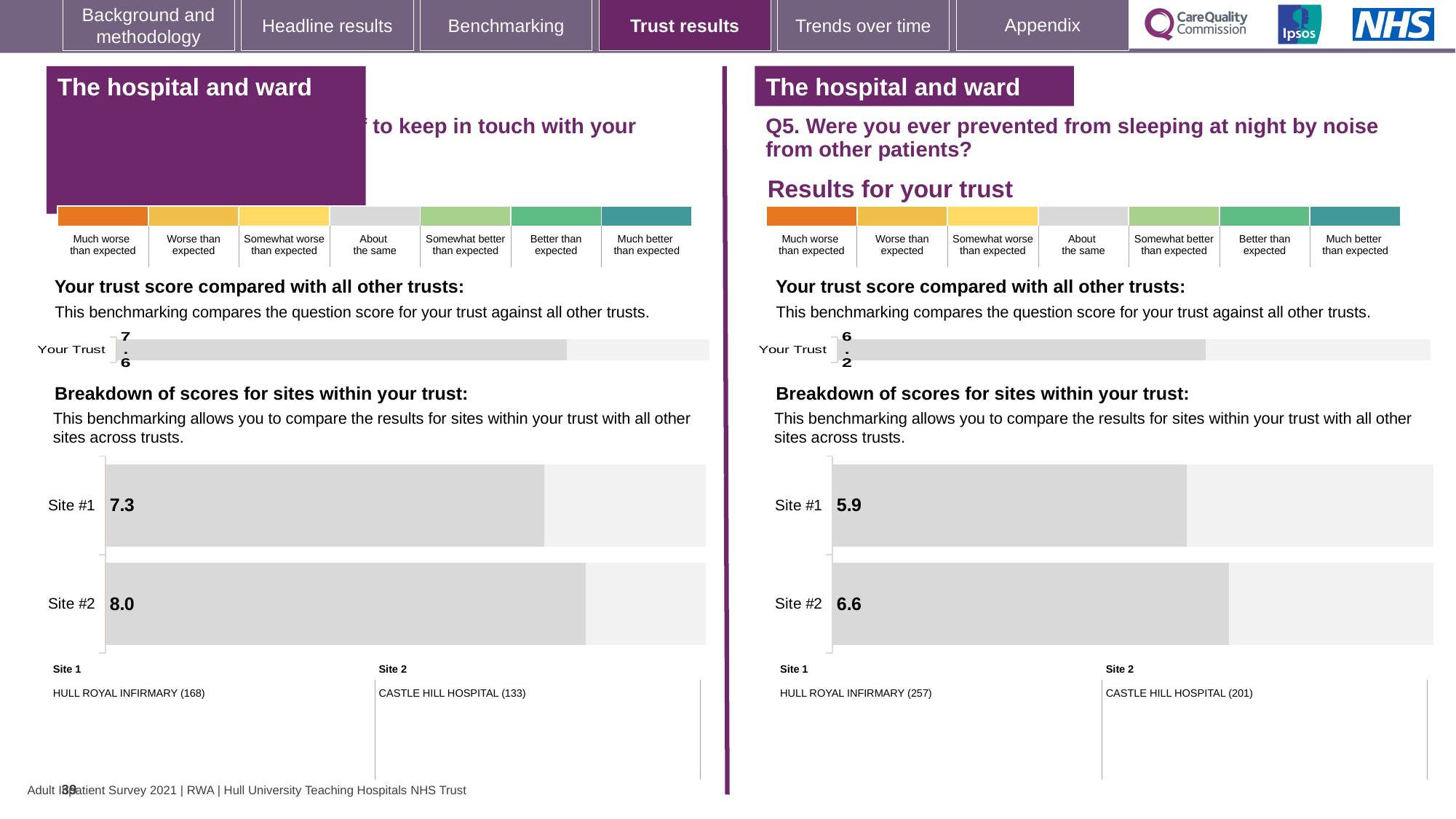
On the left-hand site breakdown chart, what is the difference between the Site #2 score and the Site #1 score? 0.7 On the left-hand site breakdown chart, which site has the lowest score? Site #1 On the right-hand chart for Q5, what is the difference between the Site #2 score and the Site #1 score? 0.7 On the right-hand chart for Q5 (prevented from sleeping at night by noise from other patients), what is the score for Site #2? 6.6 On the right-hand chart for Q5 (prevented from sleeping at night by noise from other patients), what is the score for Site #1? 5.9 On the right-hand chart for Q5, which site has the higher score, Site #1 or Site #2? Site #2 What type of chart is used for the site breakdown on the right-hand side (Q5)? Bar chart On the right-hand side of the slide (Q5), what is the 'Your Trust' score shown in the trust benchmarking bar? 6.2 On the left-hand side of the slide, what is the 'Your Trust' score shown in the trust benchmarking bar? 7.6 On the left-hand site breakdown chart, what is the score for Site #1? 7.3 How many sites are shown in the site breakdown chart on the right-hand side (Q5)? 2 On the left-hand site breakdown chart, what is the score for Site #2? 8.0